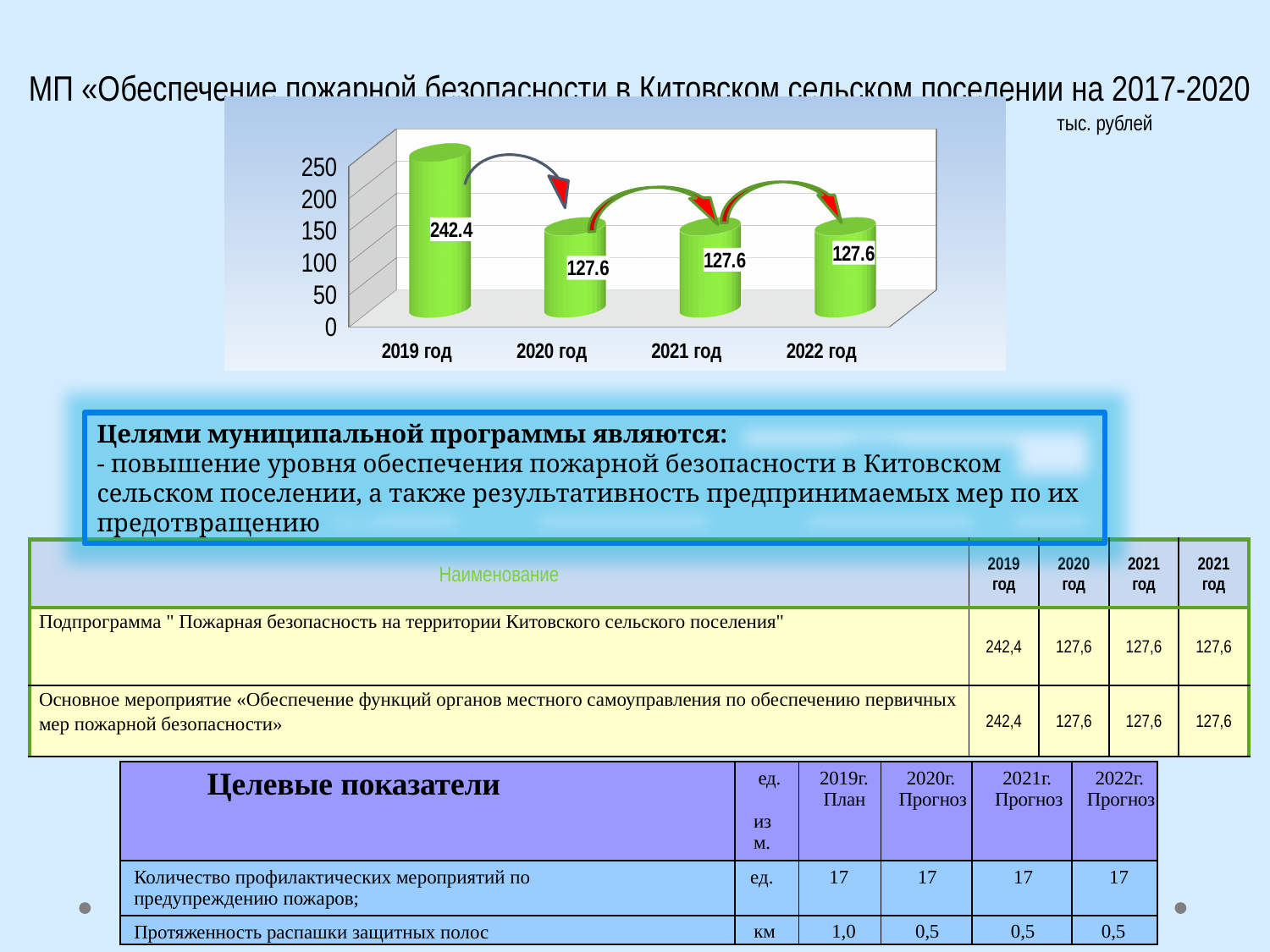
Which is larger, the value for 2019 год or the value for 2021 год? 2019 год Which year has the highest value? 2019 год How many years are shown on the x axis of the chart? 4 What is the value for 2022 год? 127.6 Do the values rise or fall from 2019 год to 2020 год? fall Is the value for 2019 год greater or less than 200? greater What is the difference between the values for 2019 год and 2020 год? 114.8 What is the value for 2020 год? 127.6 Is the value for 2021 год greater or less than 150? less What unit is indicated for the chart values? тыс. рублей What is the value for 2019 год? 242.4 What kind of chart is shown on the slide? bar chart